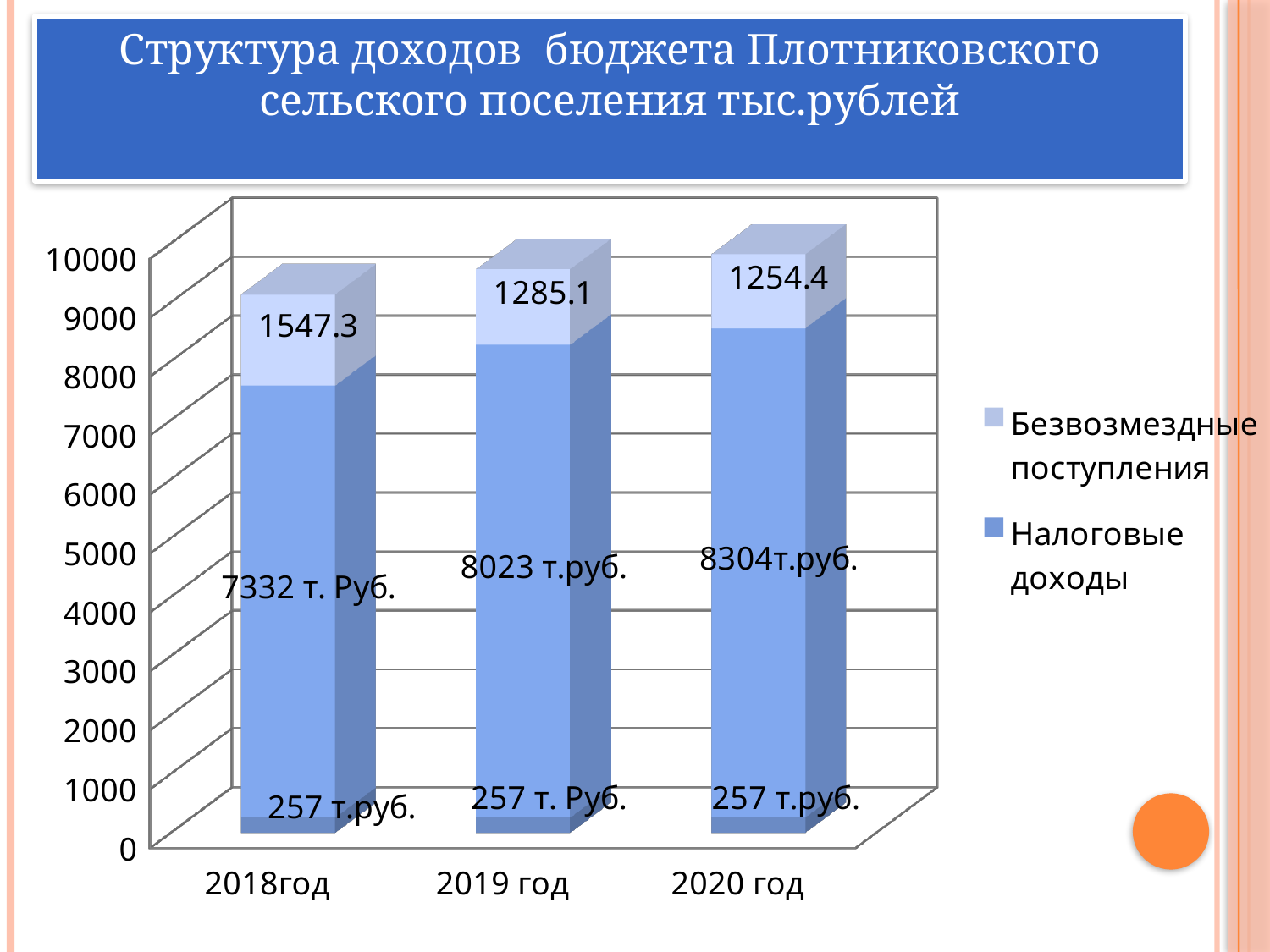
What value is printed on the bottom segment of the 2018год bar? 257 т.руб. What is the value of Налоговые доходы for 2020 год? 8304т.руб. What kind of chart is shown on the slide? Stacked bar chart How many series does the legend list? 2 How many years are shown on the x axis? 3 By how much do Налоговые доходы in 2020 год exceed those in 2018год? 972 What is the value of Налоговые доходы for 2019 год? 8023 т.руб. Do the values for Налоговые доходы rise or fall from 2018год to 2020 год? Rise Which year has the lowest value for Безвозмездные поступления? 2020 год Which year has the highest value for Налоговые доходы? 2020 год What is the value of Безвозмездные поступления for 2018год? 1547.3 Which is larger: Безвозмездные поступления in 2019 год or in 2020 год? 2019 год